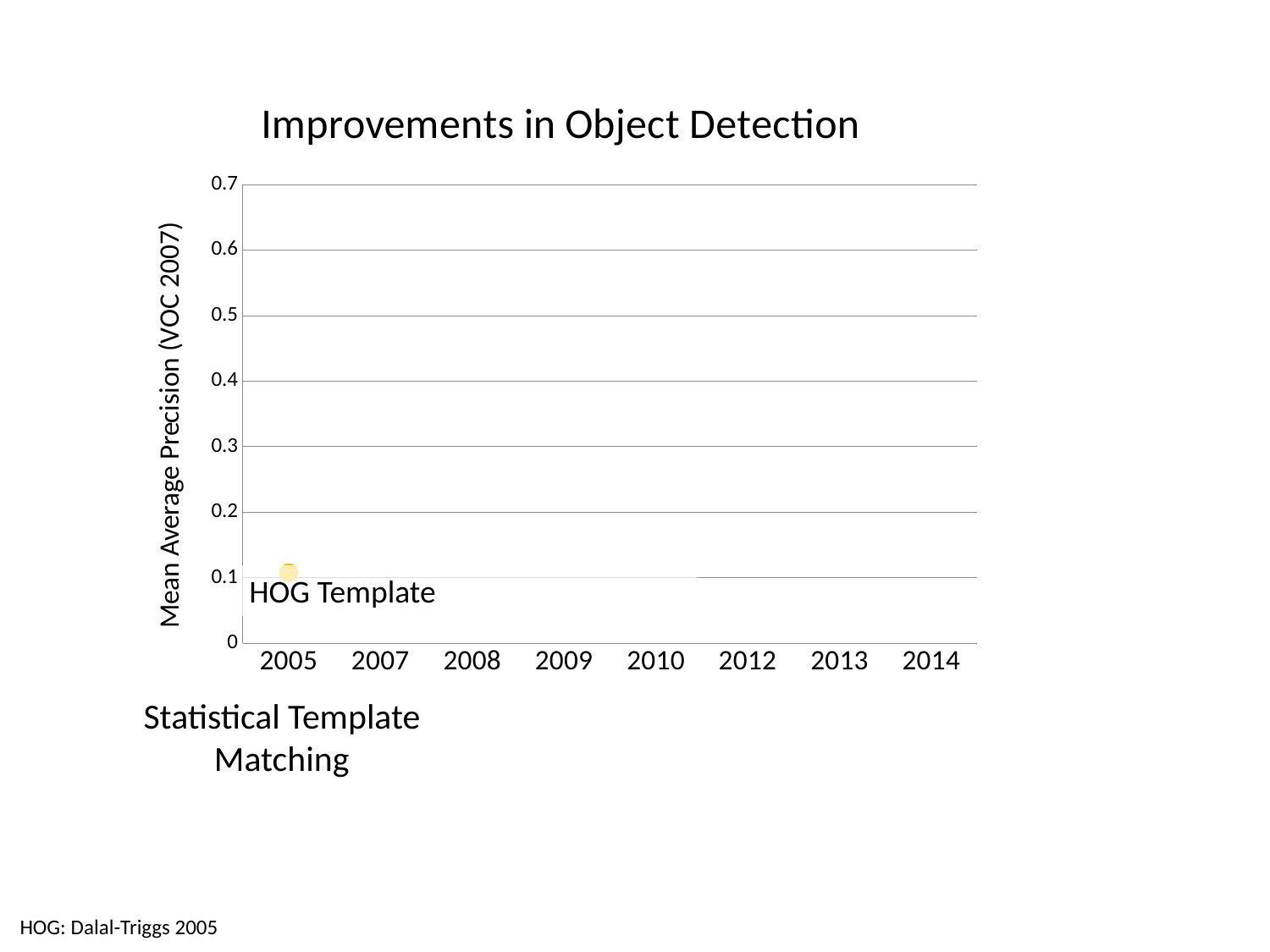
How many data points are plotted on the chart? 1 Which year has a data point plotted on the chart? 2005 What is the label on the vertical axis of the chart? Mean Average Precision (VOC 2007) What is the highest value shown on the vertical axis of the chart? 0.7 What is the first year shown on the x axis of the chart? 2005 What is the last year shown on the x axis of the chart? 2014 Is the value for 2005 greater or less than 0.3? less What is the label attached to the plotted data point on the chart? HOG Template Is the value for 2005 greater or less than 0.2? less What is the title of the chart? Improvements in Object Detection How many year categories are shown on the x axis of the chart? 8